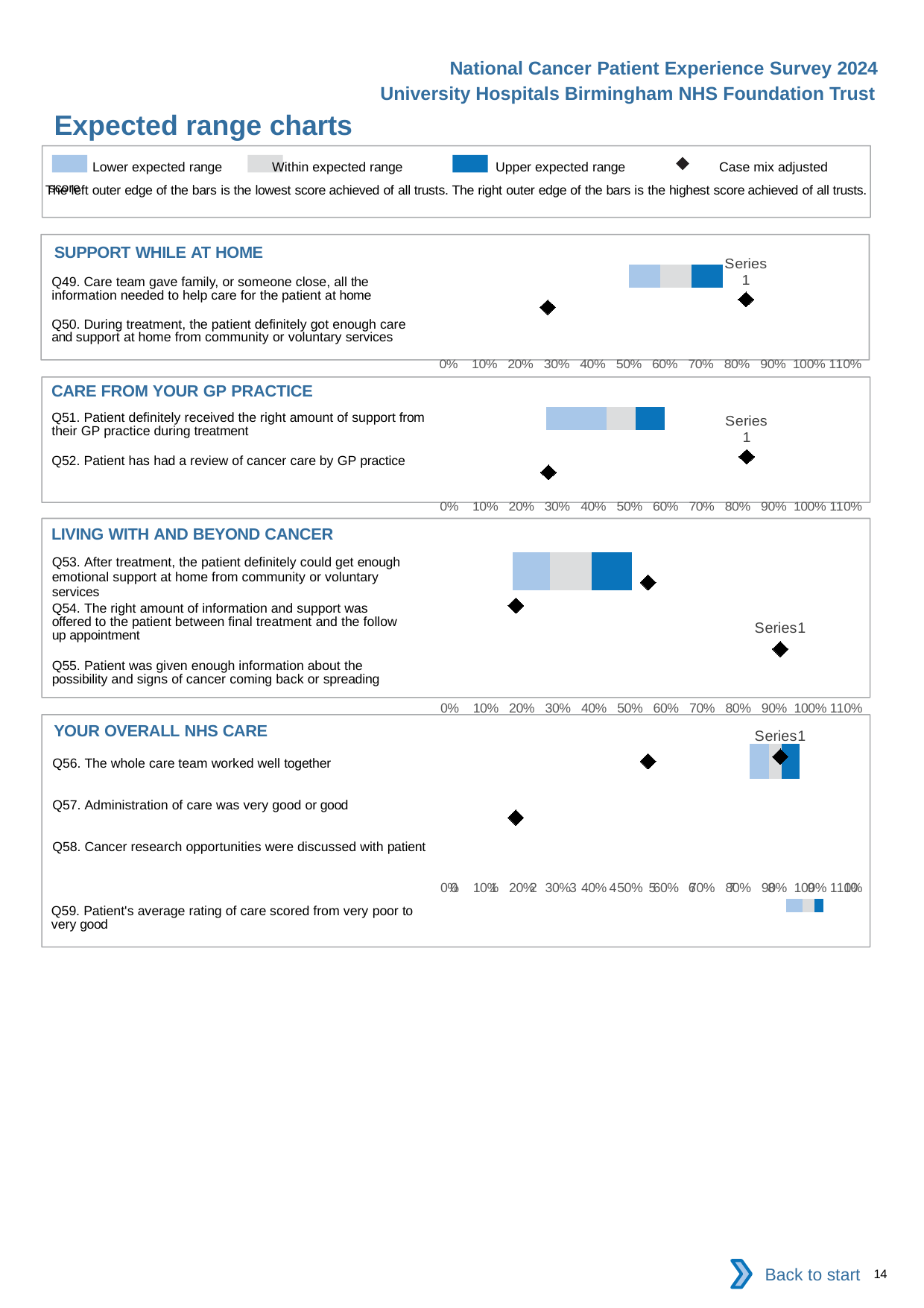
How many questions are listed in the LIVING WITH AND BEYOND CANCER chart? 3 What kind of chart is used in the SUPPORT WHILE AT HOME section? bar chart In the SUPPORT WHILE AT HOME chart, is the value of the leftmost diamond marker greater or less than 40%? less In the YOUR OVERALL NHS CARE chart, is the value of the leftmost diamond marker greater or less than 30%? less In the CARE FROM YOUR GP PRACTICE chart, is the value of the rightmost diamond marker greater or less than 70%? greater How many questions are listed in the CARE FROM YOUR GP PRACTICE chart? 2 According to the legend, what does the diamond marker represent? Case mix adjusted score How many questions are listed in the YOUR OVERALL NHS CARE chart? 4 What is the highest tick label shown on the x axis of the CARE FROM YOUR GP PRACTICE chart? 110% How many entries does the legend at the top of the slide list? 4